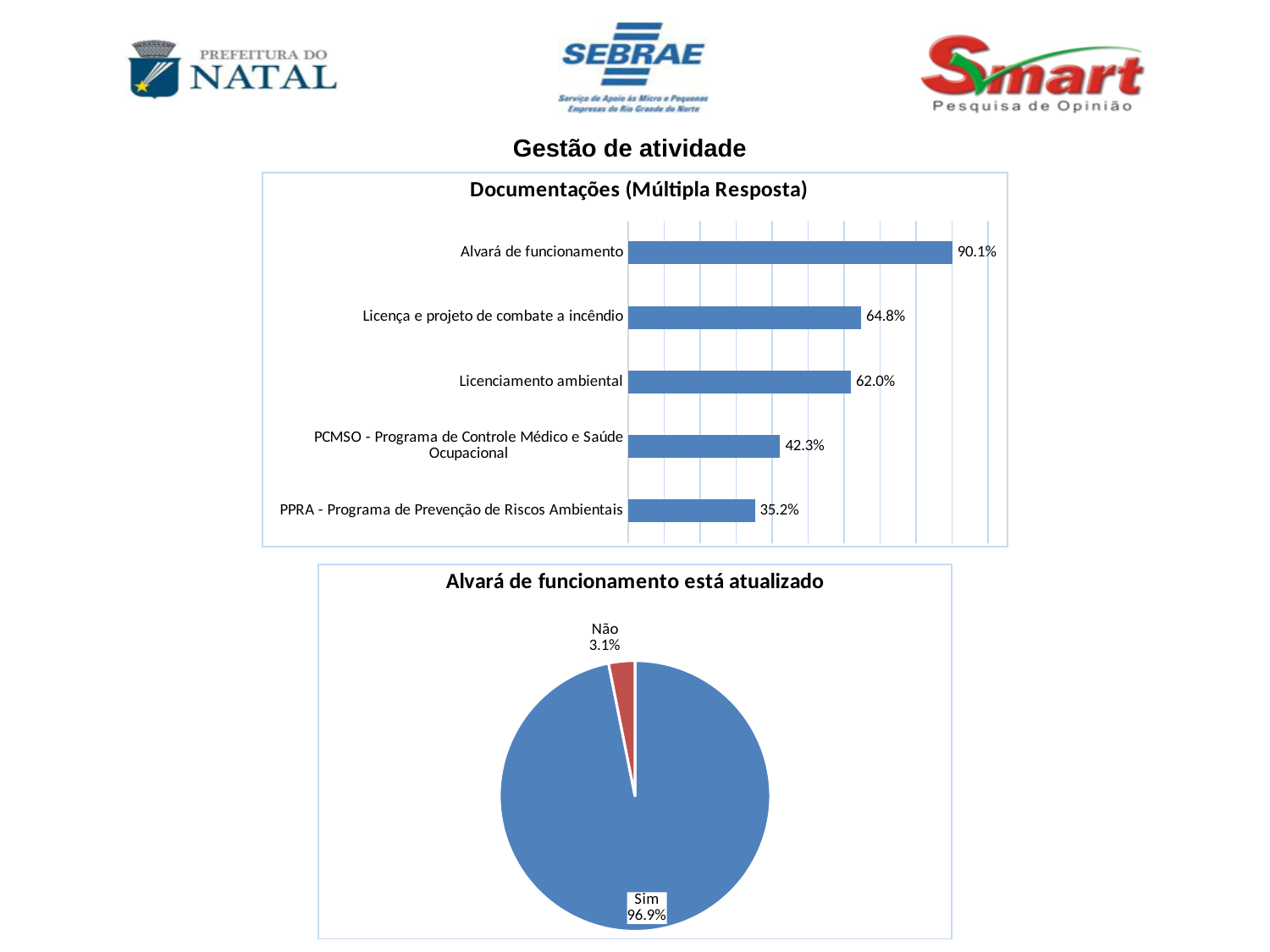
In the 'Documentações (Múltipla Resposta)' chart, what is the value for Alvará de funcionamento? 90.1% In the 'Documentações (Múltipla Resposta)' chart, what is the value for PPRA - Programa de Prevenção de Riscos Ambientais? 35.2% In the 'Documentações (Múltipla Resposta)' chart, which category has the lowest value? PPRA - Programa de Prevenção de Riscos Ambientais How many categories are shown in the 'Documentações (Múltipla Resposta)' chart? 5 In the 'Documentações (Múltipla Resposta)' chart, what is the difference between Licença e projeto de combate a incêndio and Licenciamento ambiental? 2.8% What kind of chart is 'Documentações (Múltipla Resposta)'? Bar chart In the 'Alvará de funcionamento está atualizado' chart, what share of the pie is Sim? 96.9% What kind of chart is 'Alvará de funcionamento está atualizado'? Pie chart In the 'Documentações (Múltipla Resposta)' chart, which is larger: PCMSO - Programa de Controle Médico e Saúde Ocupacional or PPRA - Programa de Prevenção de Riscos Ambientais? PCMSO - Programa de Controle Médico e Saúde Ocupacional In the 'Documentações (Múltipla Resposta)' chart, which category has the highest value? Alvará de funcionamento In the 'Alvará de funcionamento está atualizado' chart, what is the value for Não? 3.1% In the 'Documentações (Múltipla Resposta)' chart, what is the value for Licenciamento ambiental? 62.0%